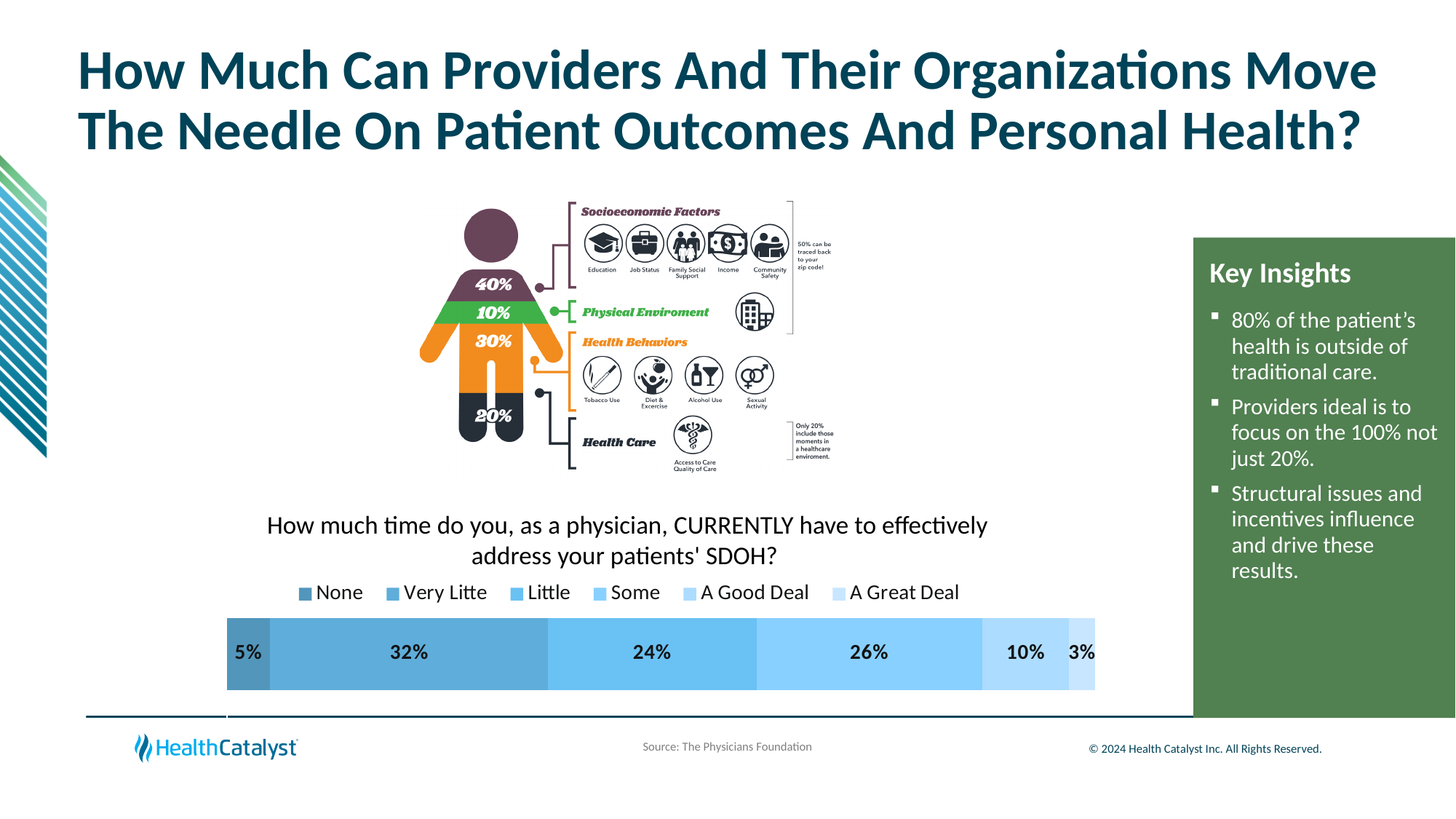
In the chart titled "How much time do you, as a physician, CURRENTLY have to effectively address your patients' SDOH?", what percentage of physicians answered "None"? 5% In the stacked bar chart about time to address patients' SDOH, which is larger: "Some" or "A Good Deal"? Some In the stacked bar chart about time to address patients' SDOH, which response category has the smallest share? A Great Deal How many series does the legend of the stacked bar chart about time to address patients' SDOH list? 6 In the stacked bar chart about time to address patients' SDOH, which response category has the largest share? Very Litte In the stacked bar chart about time to address patients' SDOH, what is the value for "Little"? 24% In the stacked bar chart about time to address patients' SDOH, what is the value for "Some"? 26% In the stacked bar chart about time to address patients' SDOH, what is the value for "A Good Deal"? 10% In the stacked bar chart about time to address patients' SDOH, what is the difference between the "Very Litte" and "Little" values? 8% In the stacked bar chart about time to address patients' SDOH, what is the combined total of "None" and "Very Litte"? 37% In the stacked bar chart about time to address patients' SDOH, what is the value for "A Great Deal"? 3% What kind of chart is used to show how much time physicians have to address patients' SDOH? Stacked bar chart